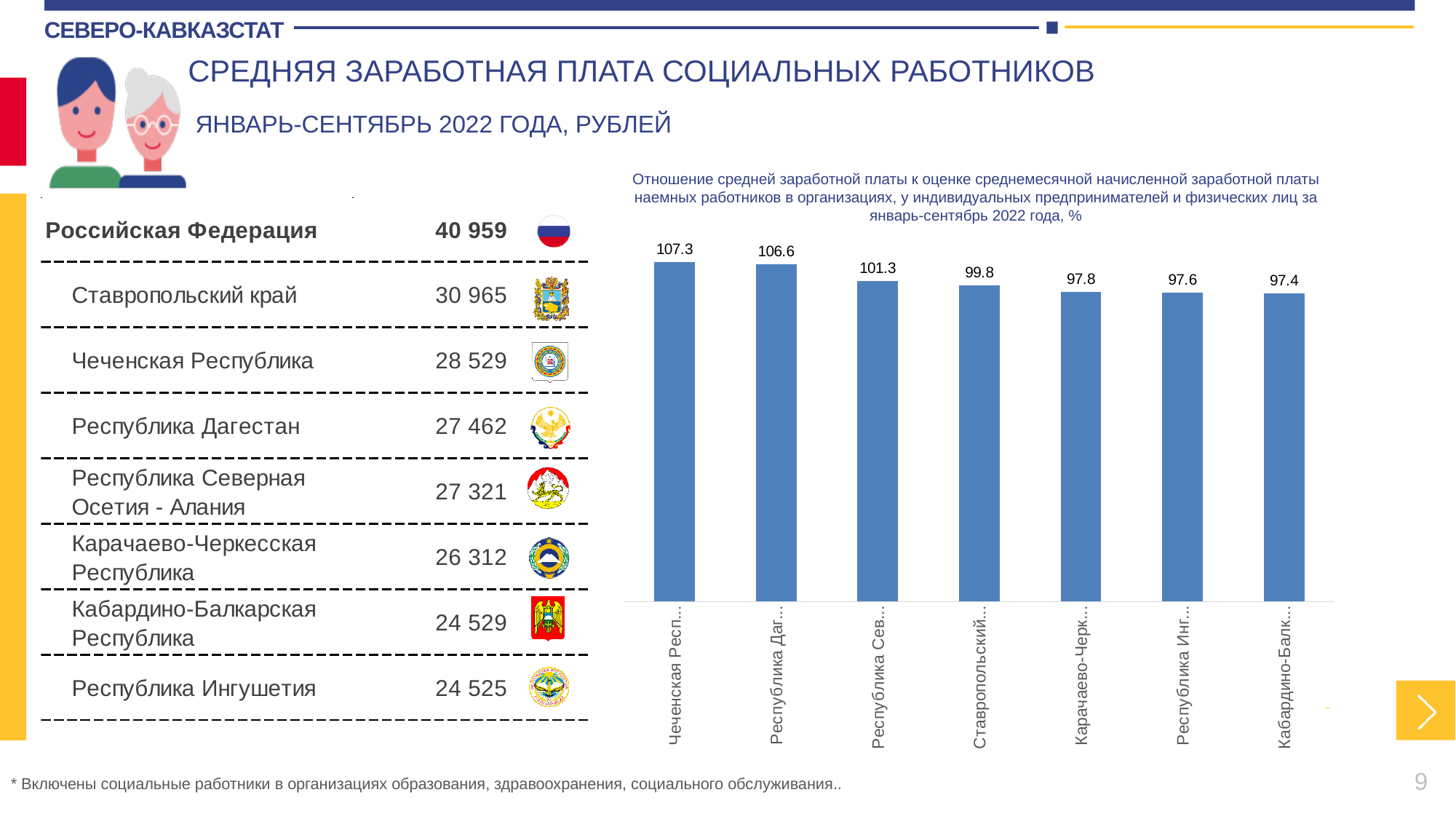
Which category has the lowest value in the chart? Кабардино-Балк... What colour are the bars in the chart? blue Do the values in the chart rise or fall from left to right? fall What value is shown for the bar labelled "Чеченская Респ..." in the chart? 107.3 What value is shown for the bar labelled "Ставропольский..." in the chart? 99.8 What value is shown for the bar labelled "Карачаево-Черк..." in the chart? 97.8 What is the difference between the values for "Чеченская Респ..." and "Кабардино-Балк..." in the chart? 9.9 Which is larger in the chart: the value for "Республика Даг..." or the value for "Республика Сев..."? Республика Даг... What is the difference between the values for "Республика Даг..." and "Республика Сев..." in the chart? 5.3 How many bars are plotted in the chart? 7 What kind of chart is shown on the slide? bar chart Which category has the highest value in the chart? Чеченская Респ...